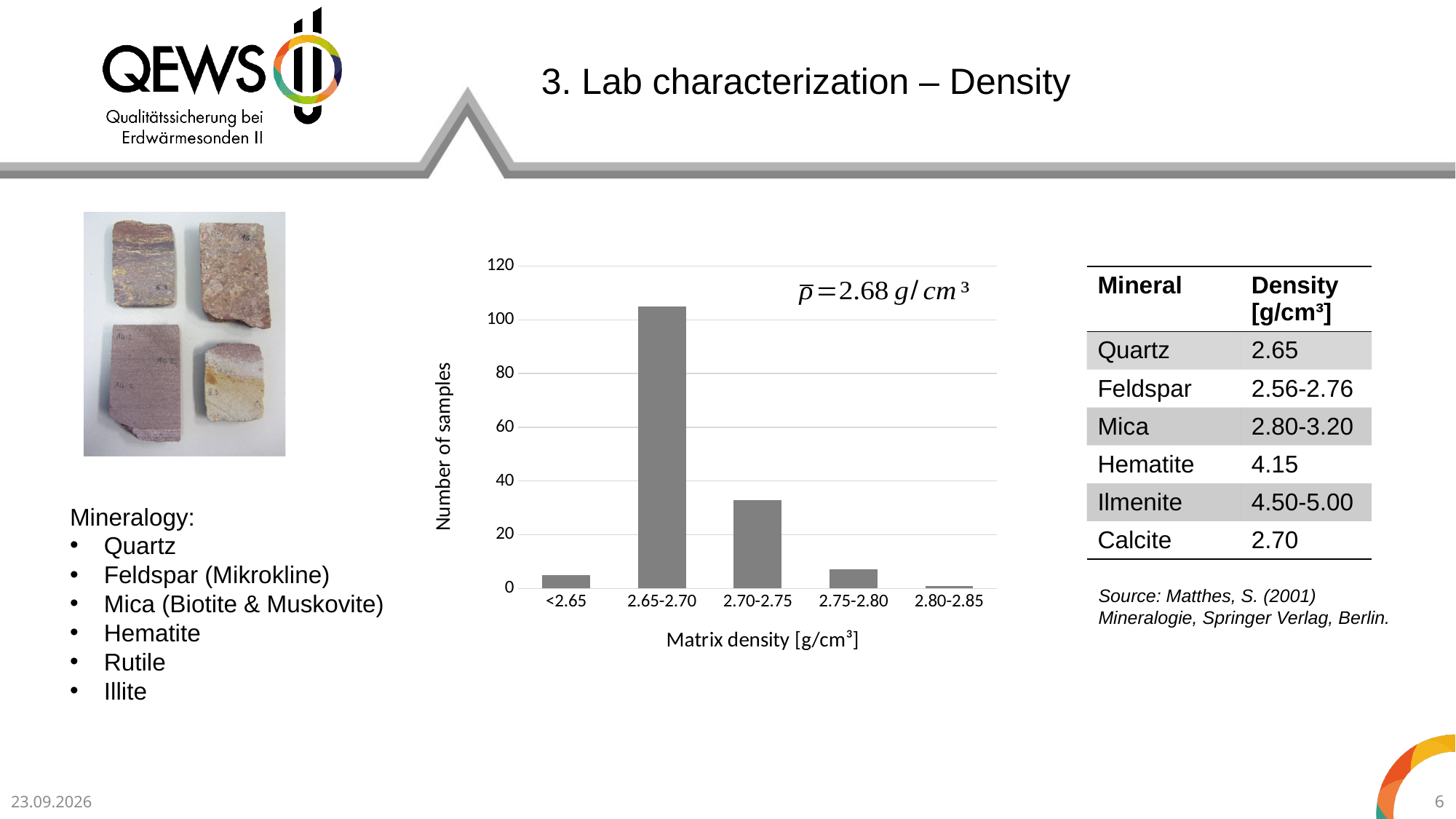
Which matrix density category has the lowest number of samples? 2.80-2.85 What is the label of the y axis of the chart? Number of samples Which category has more samples, 2.70-2.75 or 2.75-2.80? 2.70-2.75 Which matrix density category has the highest number of samples? 2.65-2.70 Which category has more samples, <2.65 or 2.65-2.70? 2.65-2.70 Is the number of samples for <2.65 greater or less than 20? less Is the number of samples for 2.70-2.75 greater or less than 40? less How many density categories are shown on the x axis of the chart? 5 Is the number of samples for 2.70-2.75 greater or less than 20? greater What mean density value is annotated on the chart? 2.68 g/cm³ What kind of chart is shown on the slide? bar chart